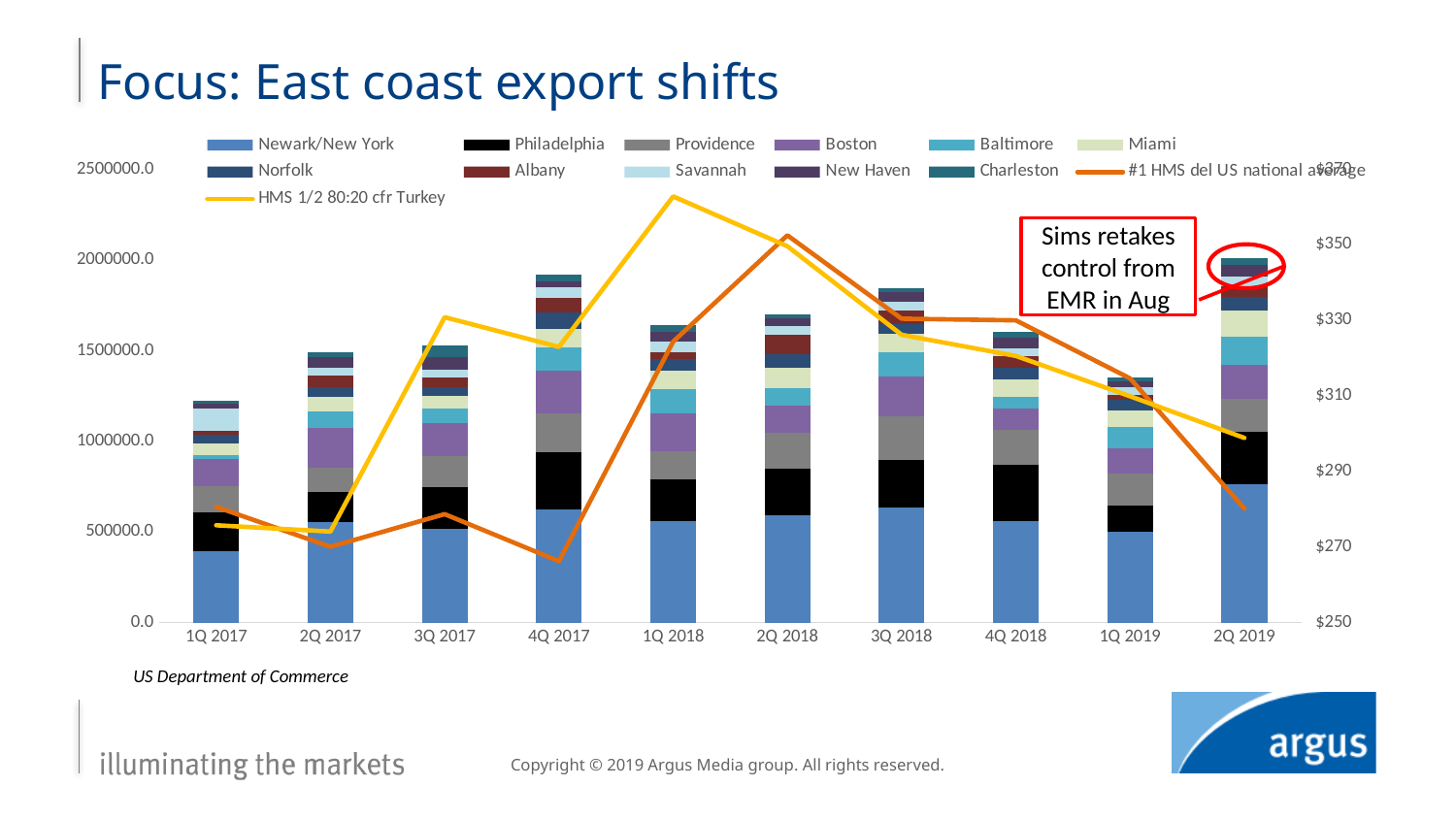
How many quarters are shown along the x axis? 10 What kind of chart is shown on the slide? Stacked bar chart with line series Which quarter has the tallest stacked bar? 2Q 2019 What is the title of the chart on the slide? Focus: East coast export shifts How many series does the legend list? 13 In which quarter does the HMS 1/2 80:20 cfr Turkey line reach its highest point? 1Q 2018 Does the HMS 1/2 80:20 cfr Turkey line rise or fall from 1Q 2018 to 2Q 2019? fall Is the total stacked bar for 1Q 2019 greater or less than 1500000.0? less Is the total stacked bar for 4Q 2017 greater or less than 1500000.0? greater Which quarter has the shortest stacked bar? 1Q 2017 Is the #1 HMS del US national average value for 2Q 2019 greater or less than $290? less In which quarter does the #1 HMS del US national average line reach its lowest point? 4Q 2017